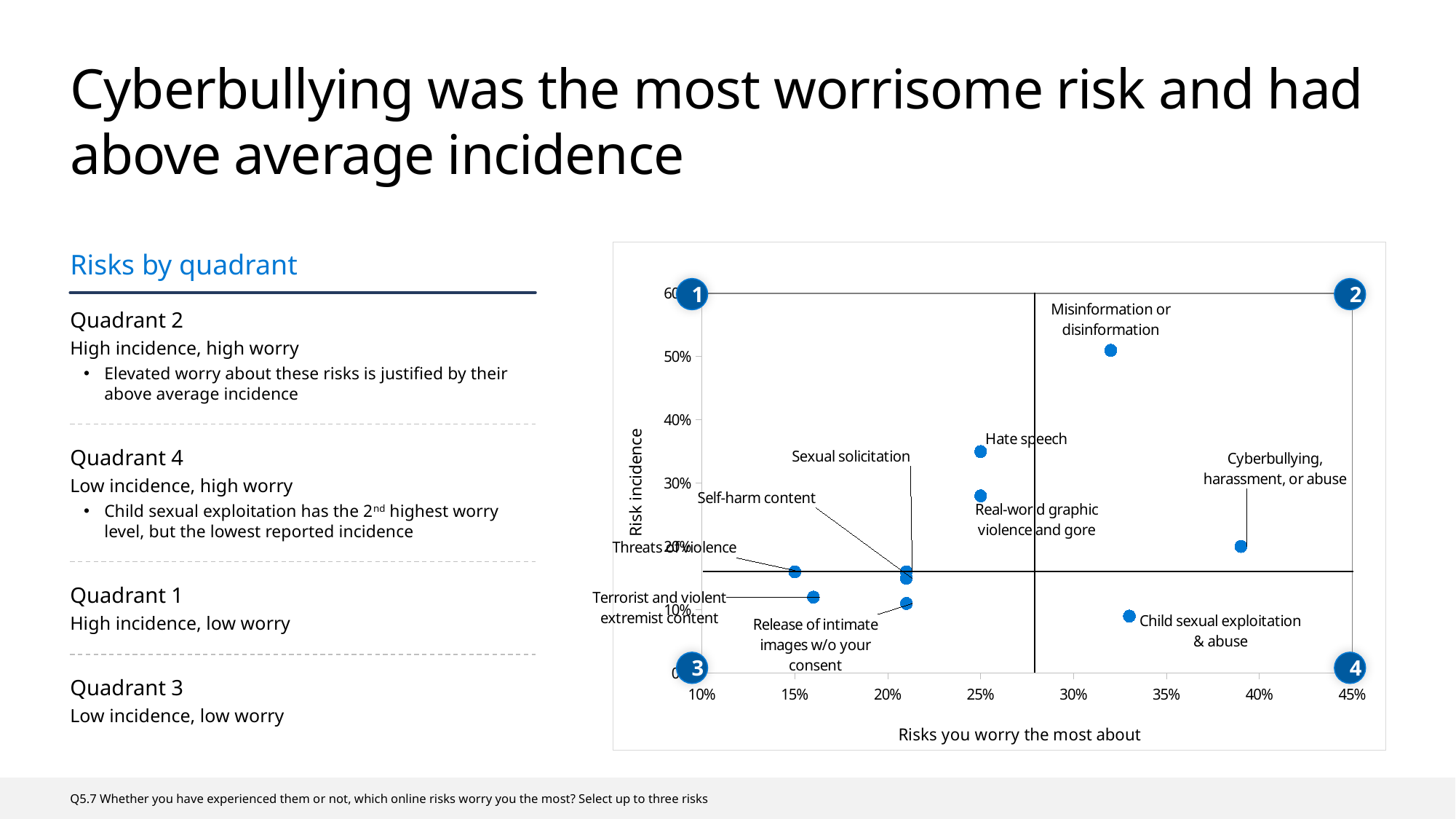
How many risks are plotted as points on the chart? 10 What is the title of the vertical axis of the chart? Risk incidence What kind of chart is shown on the slide? Scatter chart What is the title of the horizontal axis of the chart? Risks you worry the most about Which has the higher worry value, Cyberbullying, harassment, or abuse or Child sexual exploitation & abuse? Cyberbullying, harassment, or abuse Is the worry value for Cyberbullying, harassment, or abuse greater or less than 35%? greater Which risk has the highest risk incidence on the chart? Misinformation or disinformation Which risk is furthest to the right on the 'Risks you worry the most about' axis? Cyberbullying, harassment, or abuse Which has the higher risk incidence, Hate speech or Real-world graphic violence and gore? Hate speech Is the risk incidence for Misinformation or disinformation greater or less than 40%? greater Is the risk incidence for Hate speech greater or less than 30%? greater